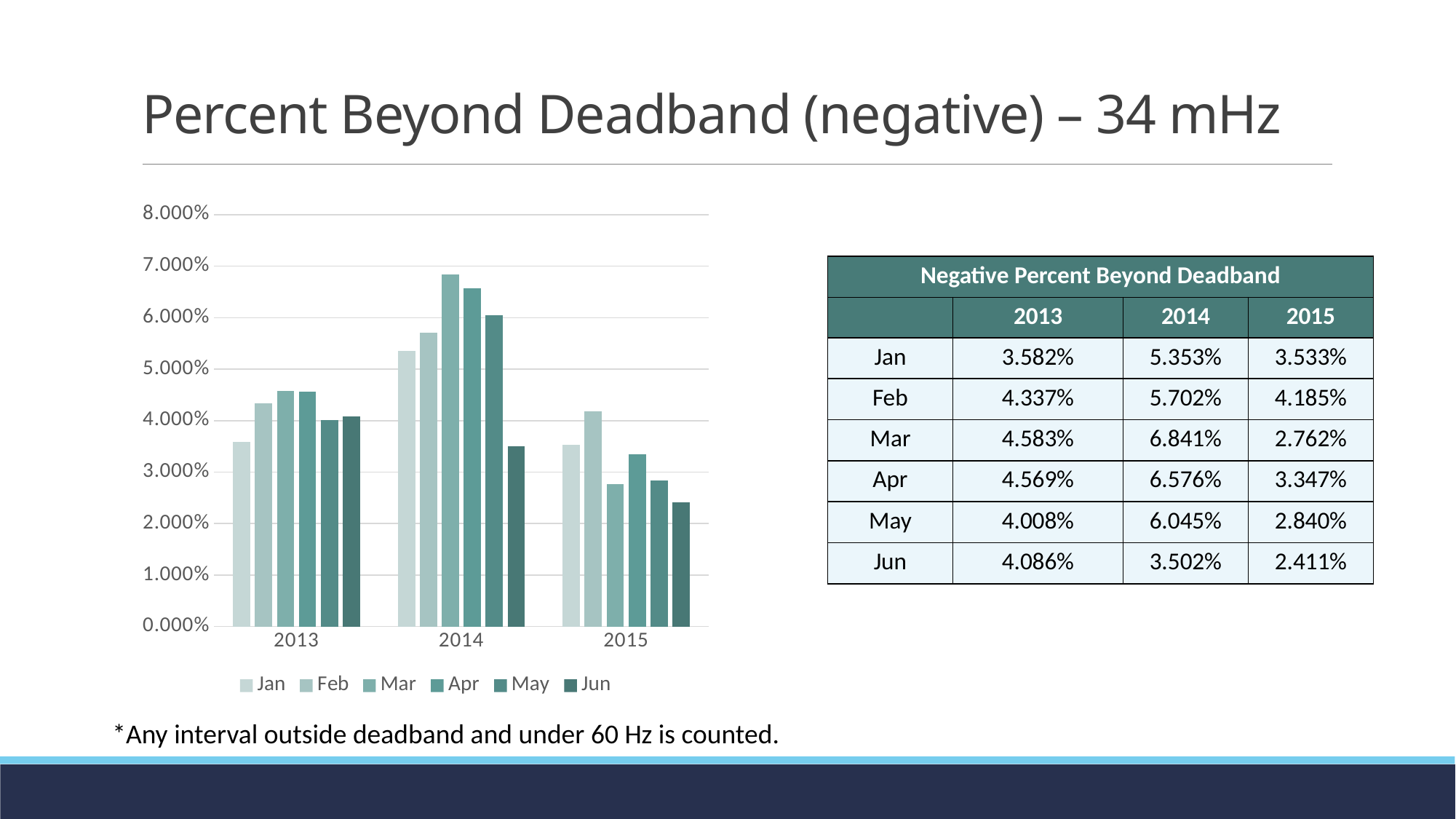
Is the value for Mar in 2014 greater or less than 6.000%? greater What kind of chart is shown on the slide? bar chart Which month is listed first in the chart legend? Jan According to the table, what is the negative percent beyond deadband for Jun 2015? 2.411% Using the table values, what is the difference between Jan 2014 and Jan 2013? 1.771% According to the table, what is the negative percent beyond deadband for Mar 2014? 6.841% Is the value for Jun in 2015 greater or less than 3.000%? less Which year has the tallest bar for Mar? 2014 How many series does the chart legend list? 6 How many year categories are shown on the x axis of the chart? 3 Is the Jan bar for 2014 larger or smaller than the Jan bar for 2013? larger Which month has the lowest bar in 2015? Jun